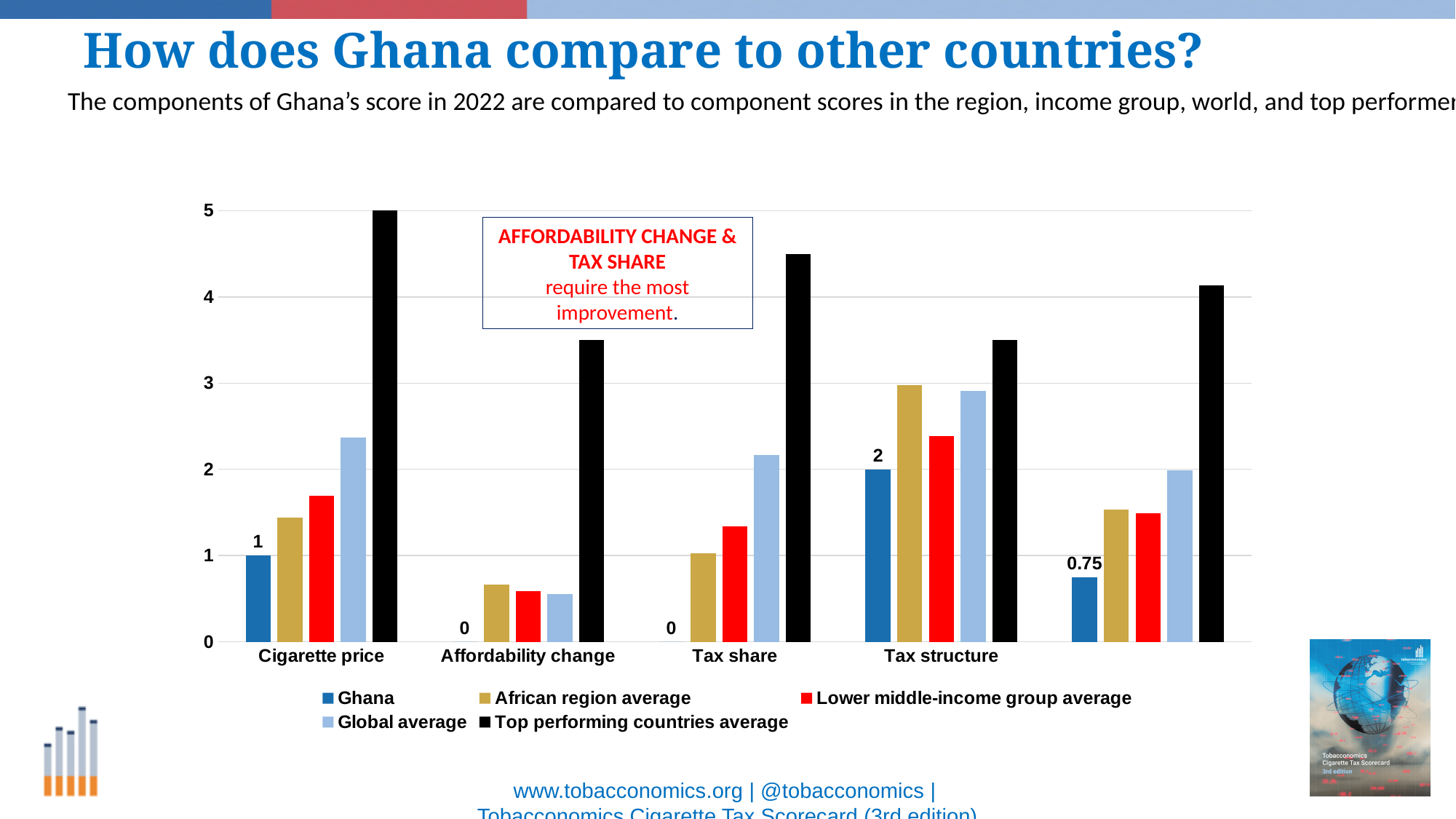
Which series has the lowest value for Cigarette price? Ghana What is Ghana's score for Tax structure? 2 What kind of chart is shown on the slide? Bar chart Is the African region average for Tax structure greater or less than 2? greater Is the Global average for Cigarette price greater or less than 2? greater For Tax structure, which is larger: Ghana or the African region average? African region average What is Ghana's score for Cigarette price? 1 How many series does the legend list? 5 What is Ghana's score for Affordability change? 0 What is Ghana's score for Tax share? 0 Which series has the highest value for Tax share? Top performing countries average What is the Top performing countries average score for Cigarette price? 5